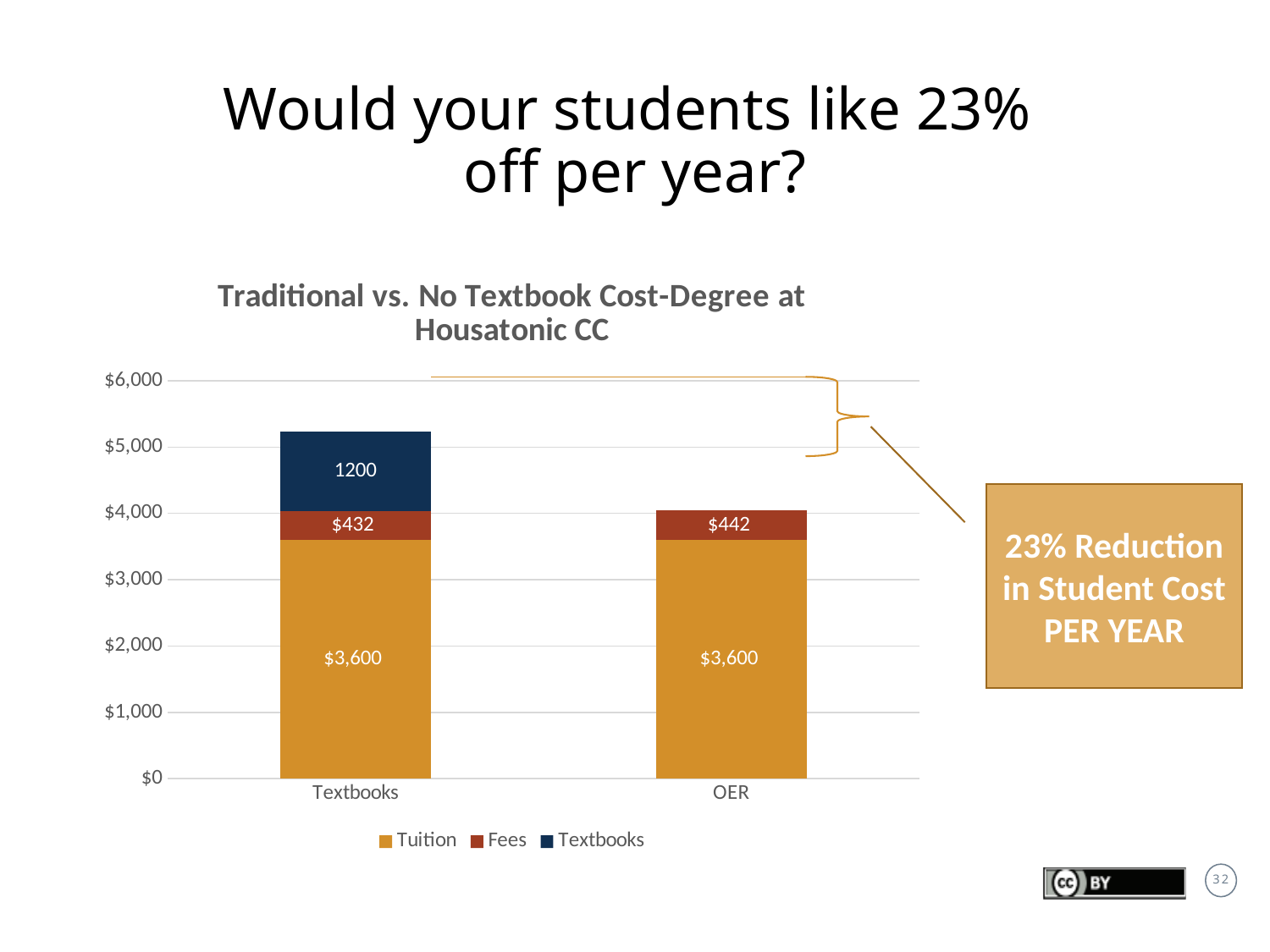
What is the Textbooks value for the Textbooks category? 1200 How many series does the legend list? 3 What is the title of the chart? Traditional vs. No Textbook Cost-Degree at Housatonic CC What is the Fees value for the Textbooks category? $432 What is the total of the stacked bar for the Textbooks category? $5,232 What type of chart is shown on the slide? Stacked bar chart What is the Tuition value for the Textbooks category? $3,600 What is the Fees value for the OER category? $442 Which category has the taller stacked bar, Textbooks or OER? Textbooks Is the total of the OER bar greater or less than $5,000? less How many categories are shown on the x axis? 2 What is the difference between the Fees value for OER and the Fees value for Textbooks? $10